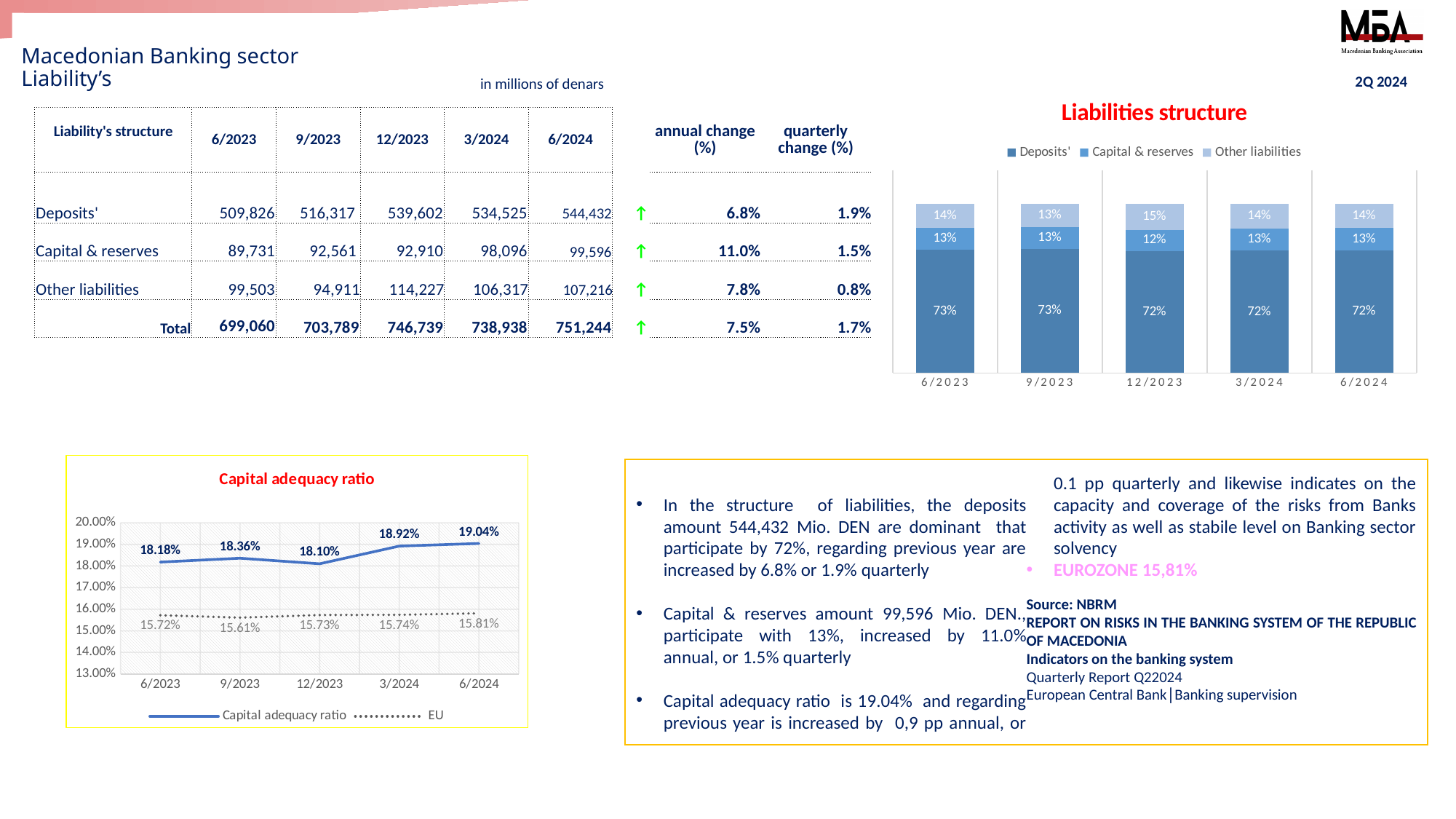
How many series does the legend of the Liabilities structure chart list? 3 How many periods are shown on the x axis of the Liabilities structure chart? 5 In the Liabilities structure chart, what share do Capital & reserves have in 12/2023? 12% In the Liabilities structure chart, what share do Other liabilities have in 12/2023? 15% In the Capital adequacy ratio chart, what is the Capital adequacy ratio value for 3/2024? 18.92% In the Capital adequacy ratio chart, in which period is the Capital adequacy ratio lowest? 12/2023 In the Liabilities structure chart, what share do Deposits' have in 6/2024? 72% In the Capital adequacy ratio chart, in which period is the Capital adequacy ratio highest? 6/2024 What kind of chart is the Liabilities structure chart? Stacked bar chart In the Capital adequacy ratio chart, which is larger in 6/2023: the Capital adequacy ratio or the EU value? Capital adequacy ratio In the Capital adequacy ratio chart, what is the EU value for 9/2023? 15.61% In the Capital adequacy ratio chart, what is the difference between the Capital adequacy ratio and the EU value in 6/2024? 3.23%